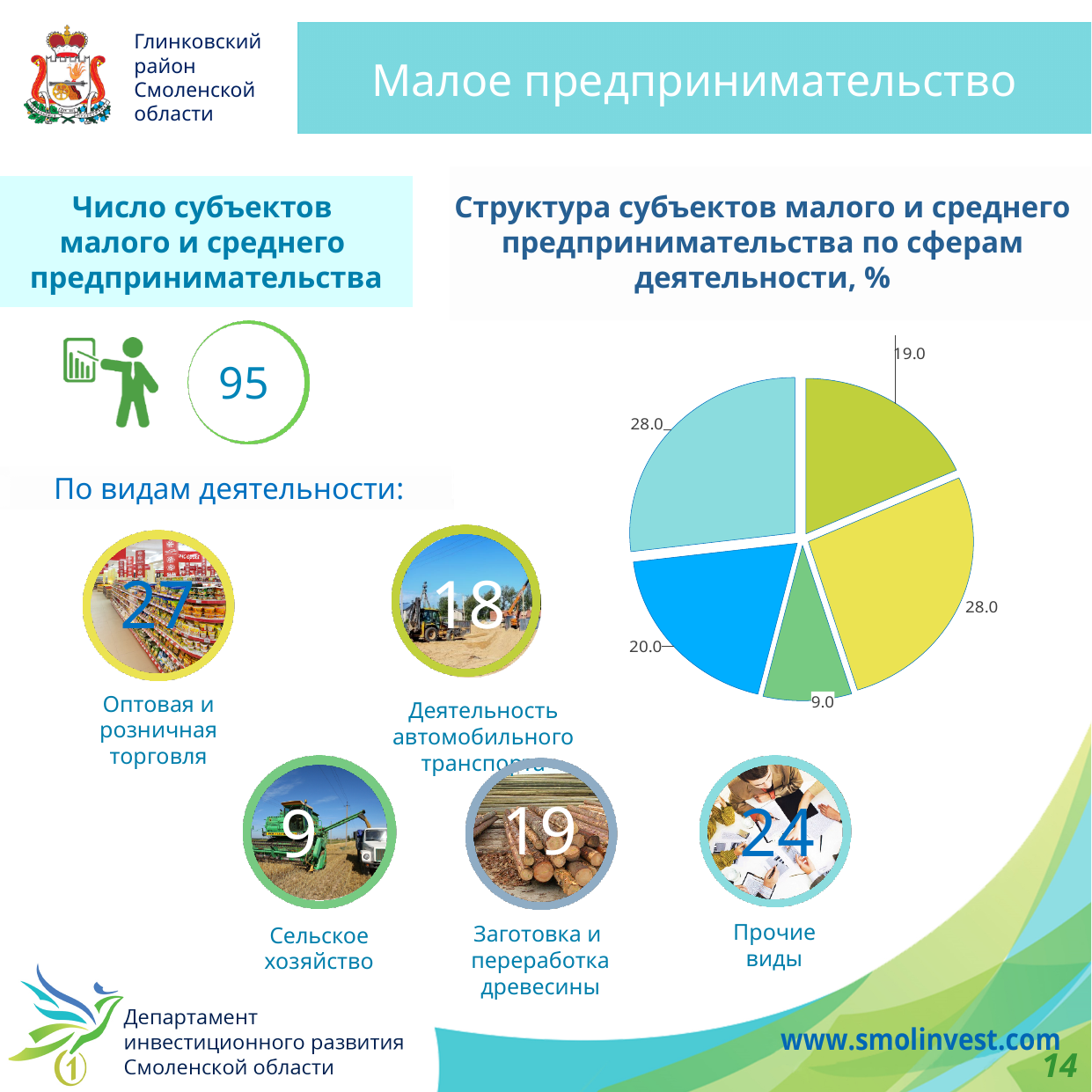
What is the difference between the slice labelled 20.0 and the slice labelled 19.0 on the pie chart? 1.0 What kind of chart is shown on the right side of the slide? pie chart How many slices does the pie chart have? 5 How many slices of the pie chart are labelled 28.0? 2 What is the difference between the largest and smallest labelled values on the pie chart? 19.0 What value is labelled at the top of the pie chart, on the olive-green slice? 19.0 What value is labelled on the dark blue slice of the pie chart? 20.0 What is the largest value labelled on the pie chart? 28.0 On the pie chart, which is larger: the dark blue slice or the green slice? the dark blue slice What value is labelled on the green slice of the pie chart? 9.0 What is the title of the pie chart on the slide? Структура субъектов малого и среднего предпринимательства по сферам деятельности, % What is the smallest value labelled on the pie chart? 9.0